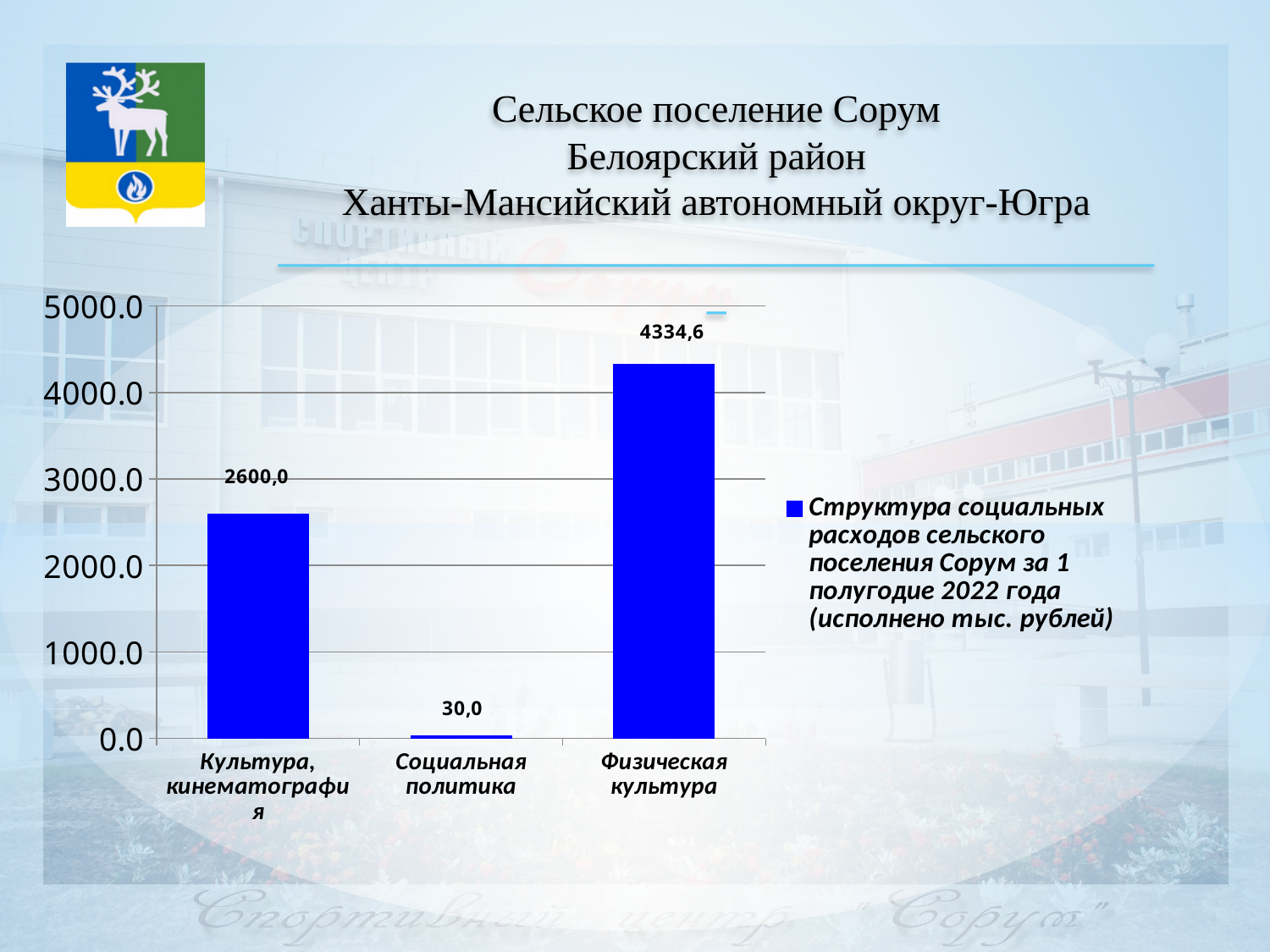
What is the value for Социальная политика? 30,0 How many series does the legend list? 1 How many categories are shown on the x axis? 3 Which is larger, the value for Культура, кинематография or the value for Физическая культура? Физическая культура What is the difference between the values for Физическая культура and Культура, кинематография? 1734,6 What is the value for Культура, кинематография? 2600,0 What is the difference between the values for Культура, кинематография and Социальная политика? 2570,0 What is the value for Физическая культура? 4334,6 Which category has the lowest value? Социальная политика Which category has the highest value? Физическая культура What kind of chart is shown on the slide? bar chart Is the value for Физическая культура greater or less than 4000.0? greater